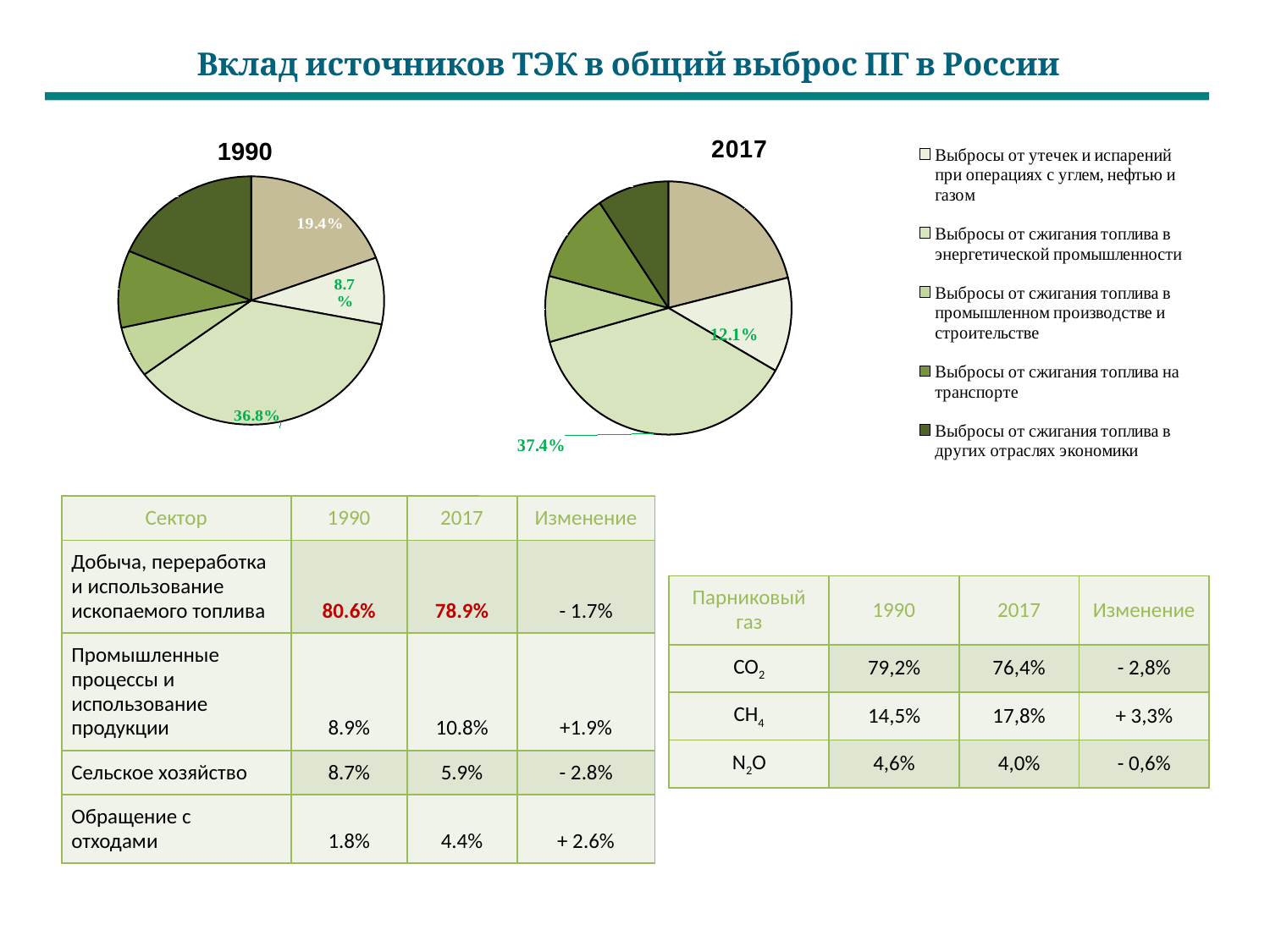
How many pie charts are on the slide? 2 In the 2017 pie chart, what is the smaller of the two labelled shares? 12.1% What are the titles of the two pie charts? 1990 and 2017 In the 1990 pie chart, what is the difference between the 19.4% slice and the 8.7% slice? 10.7 percentage points Which is larger: the largest labelled slice in the 1990 pie (36.8%) or in the 2017 pie (37.4%)? 2017 (37.4%) Which legend entry is shown in the darkest green colour? Выбросы от сжигания топлива в других отраслях экономики In the 1990 pie chart, what is the largest labelled share? 36.8% In the 2017 pie chart, what is the largest labelled share? 37.4% How many entries does the legend list? 5 In the 1990 pie chart, what is the smallest labelled share? 8.7% What type of charts are shown on the slide? Pie charts